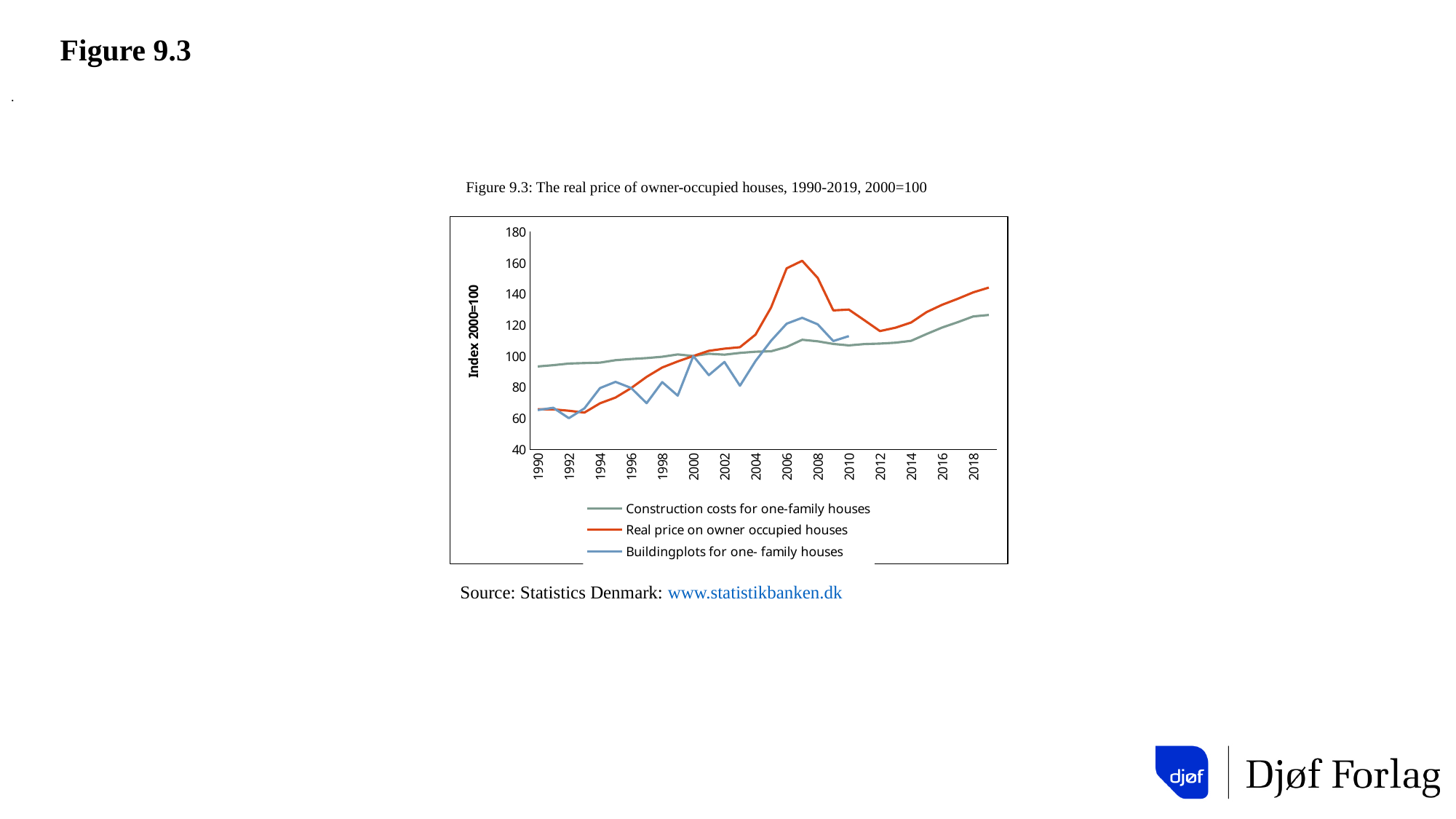
Is the value for Real price on owner occupied houses in 2018 greater or less than 120? greater Does the Construction costs for one-family houses series generally rise or fall from 1990 to 2019? rise In 1998, which series has the higher value: Buildingplots for one- family houses or Construction costs for one-family houses? Construction costs for one-family houses In 2007, which series has the higher value: Real price on owner occupied houses or Construction costs for one-family houses? Real price on owner occupied houses In which year does the Real price on owner occupied houses series reach its highest value? 2007 What is the title of the chart? Figure 9.3: The real price of owner-occupied houses, 1990-2019, 2000=100 How many series does the legend list? 3 Is the value for Buildingplots for one- family houses in 1992 greater or less than 80? less What kind of chart is shown on the slide? line chart What is the label on the vertical axis? Index 2000=100 Is the value for Construction costs for one-family houses in 1990 greater or less than 100? less